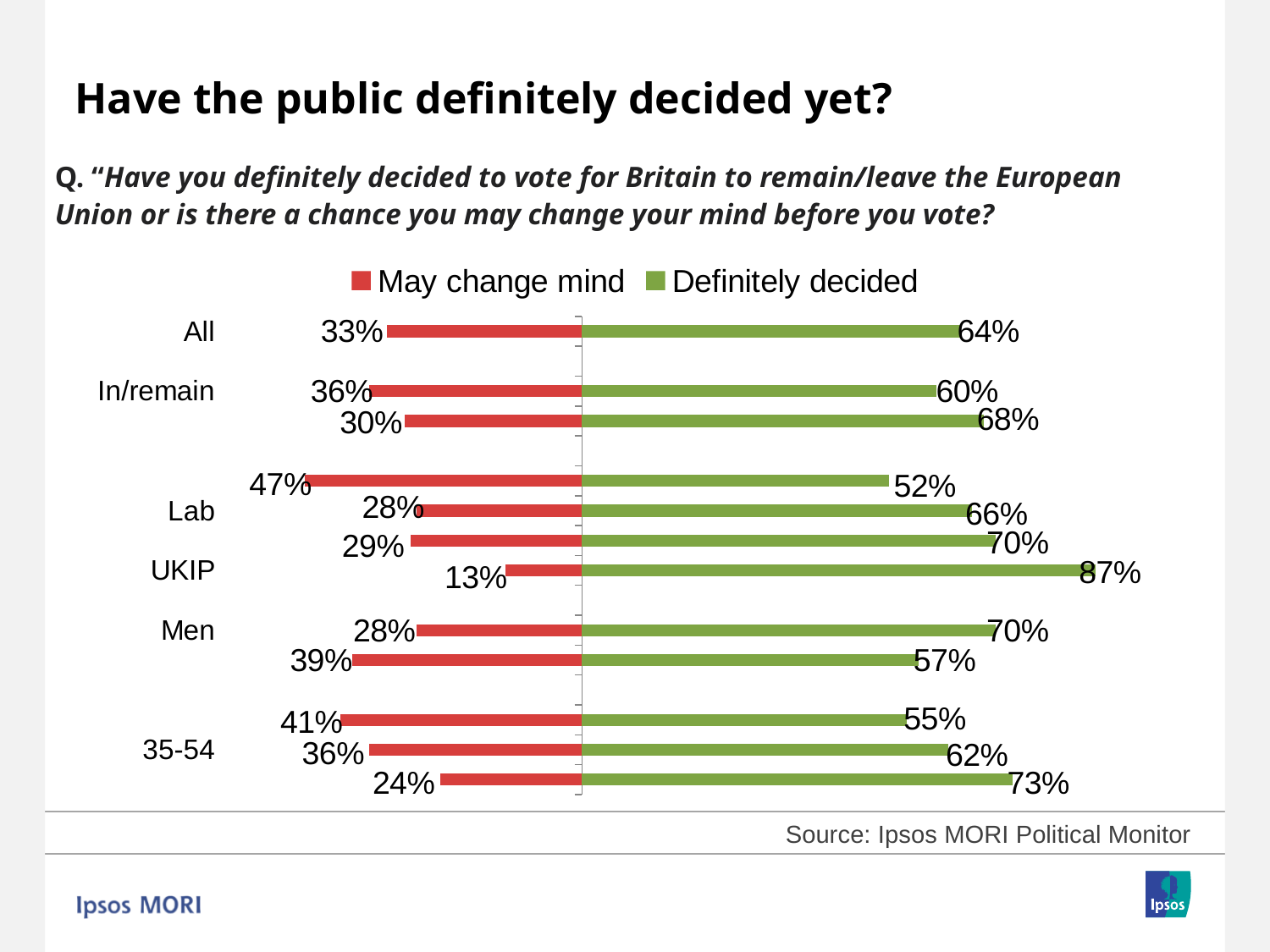
Which colour represents 'May change mind' in the chart? Red What percentage of All respondents say they may change their mind? 33% What type of chart is shown on the slide? Bar chart What is the difference between the 'Definitely decided' and 'May change mind' values for Lab? 38 percentage points What is the 'Definitely decided' value for UKIP? 87% What is the 'Definitely decided' value for Men? 70% What is the 'May change mind' value for UKIP? 13% Which labelled group has the highest 'Definitely decided' value? UKIP What percentage of All respondents say they have definitely decided? 64% Which is larger: the 'Definitely decided' value for In/remain or for Men? Men How many series does the legend list? 2 What is the 'May change mind' value for the 35-54 group? 36%